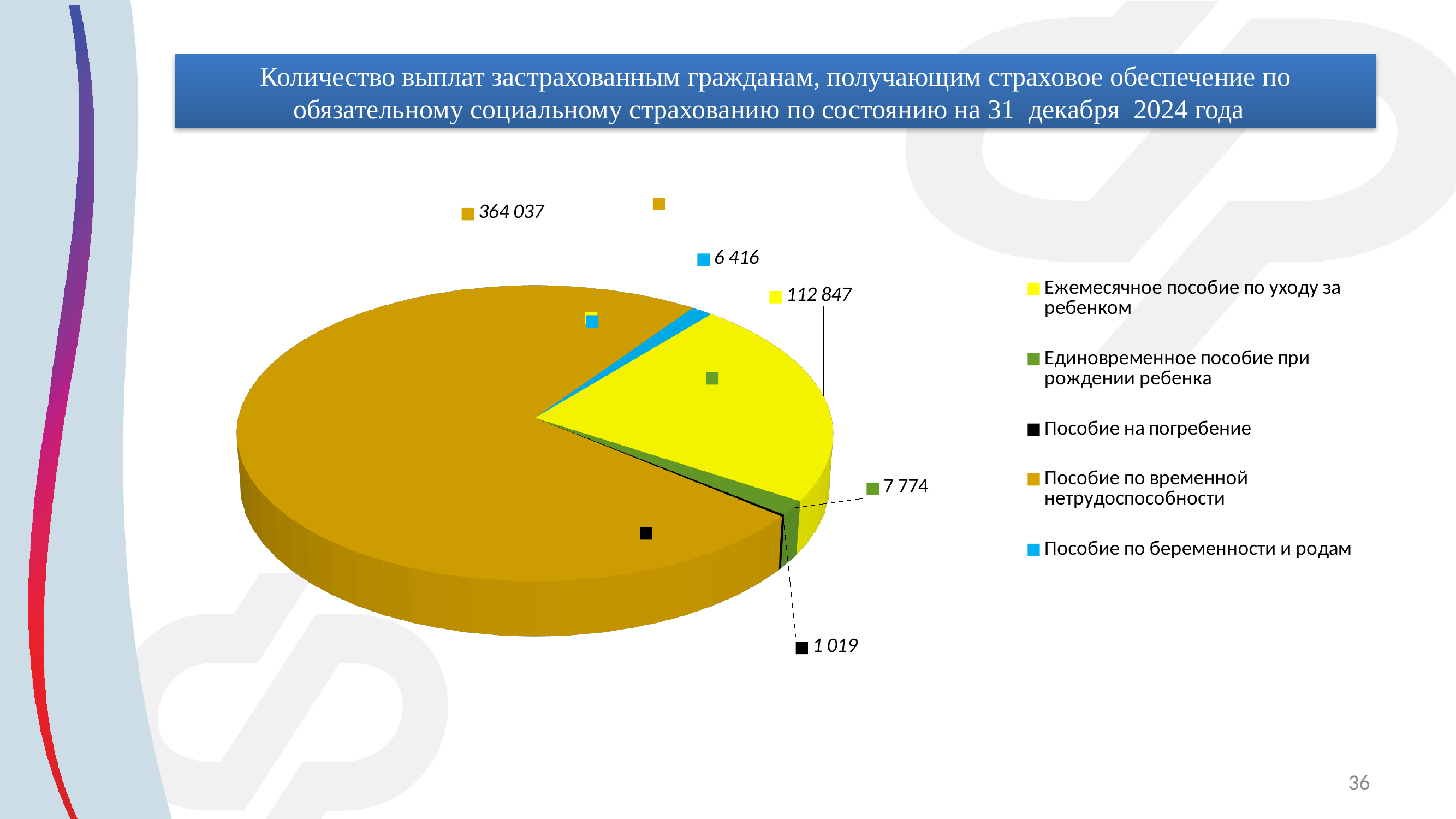
What is the difference between the values for Пособие по временной нетрудоспособности and Ежемесячное пособие по уходу за ребенком? 251 190 Which category has the largest slice of the pie? Пособие по временной нетрудоспособности What is the value for Единовременное пособие при рождении ребенка? 7 774 Which is larger: Единовременное пособие при рождении ребенка or Пособие по беременности и родам? Единовременное пособие при рождении ребенка What is the value for Пособие по беременности и родам? 6 416 What is the value for Пособие по временной нетрудоспособности? 364 037 Which category has the smallest value? Пособие на погребение How many categories does the pie chart have? 5 What kind of chart is shown on the slide? Pie chart What is the value for Ежемесячное пособие по уходу за ребенком? 112 847 What colour is the slice for Пособие по беременности и родам? Blue What is the value for Пособие на погребение? 1 019